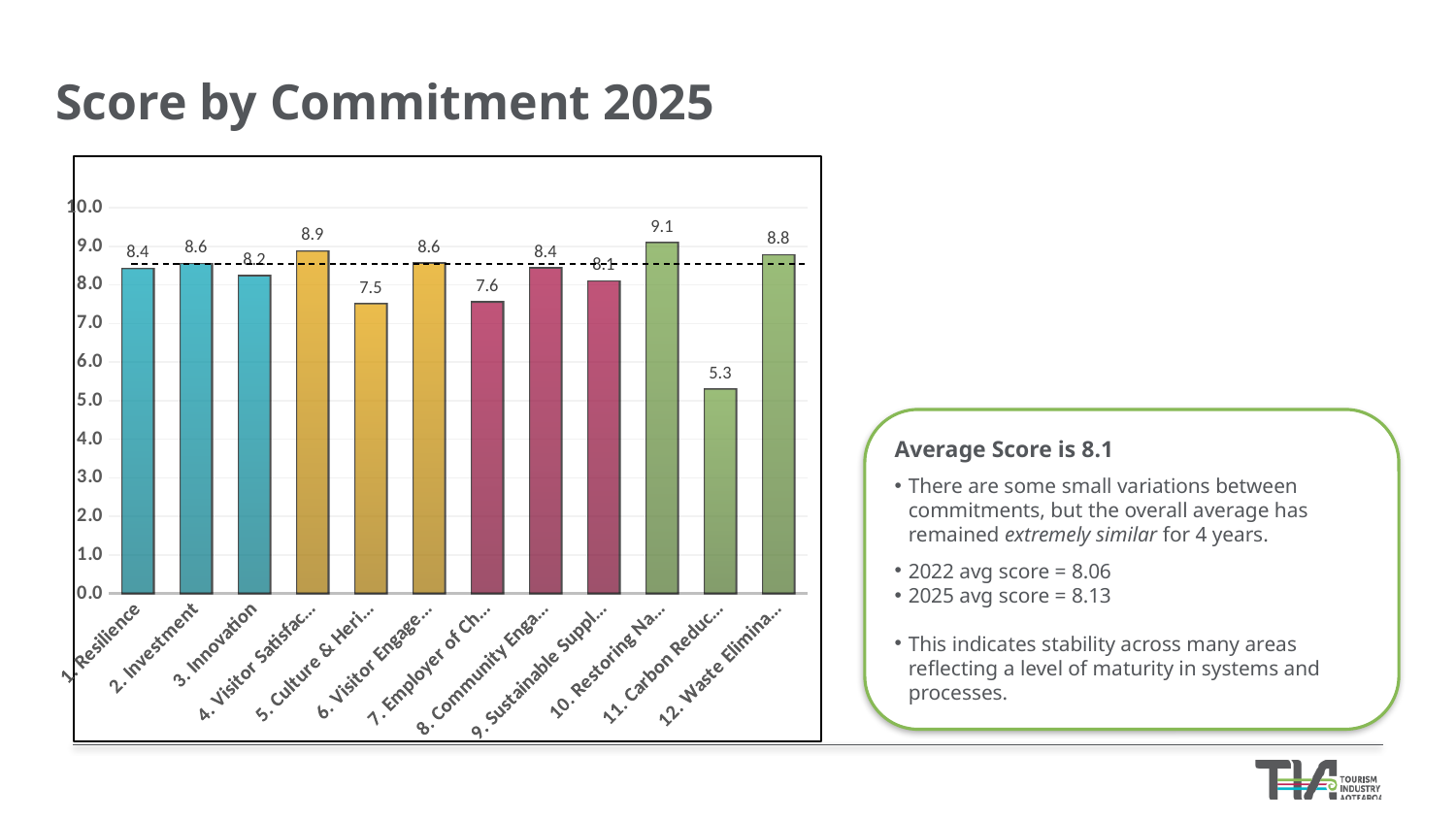
How many commitments are shown on the chart? 12 What is the difference between the scores for 2. Investment and 3. Innovation? 0.4 Is the score for commitment 11 (Carbon Reduc...) greater or less than 6.0? less What is the score shown for commitment 12 (Waste Elimina...)? 8.8 What is the score for 1. Resilience? 8.4 What is the score for 2. Investment? 8.6 Which has a higher score, 1. Resilience or 2. Investment? 2. Investment What is the difference between the highest score (commitment 10) and the lowest score (commitment 11)? 3.8 What type of chart is shown on the slide? bar chart What is the score for 3. Innovation? 8.2 Which commitment has the highest score? 10. Restoring Na... Which commitment has the lowest score? 11. Carbon Reduc...